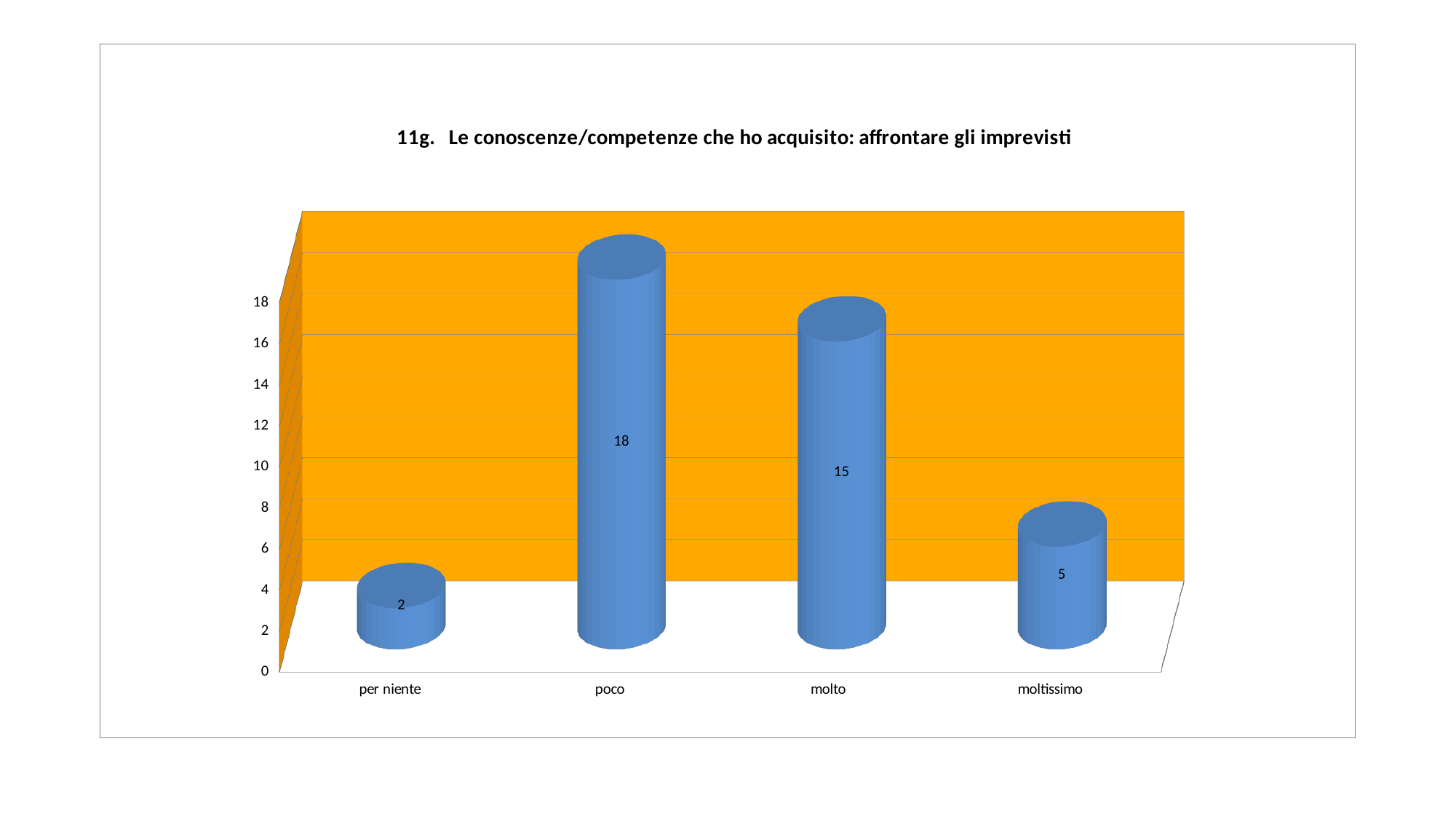
What is the difference between the values for "poco" and "molto"? 3 What kind of chart is shown on the slide? bar chart What is the title of the chart? 11g. Le conoscenze/competenze che ho acquisito: affrontare gli imprevisti How many categories are shown on the x axis? 4 What is the value for "moltissimo"? 5 Which category has the lowest value? per niente What is the difference between the values for "moltissimo" and "per niente"? 3 What is the value for "molto"? 15 What is the value for "poco"? 18 Which category has the highest value? poco What is the value for "per niente"? 2 Which is larger, the value for "molto" or the value for "moltissimo"? molto